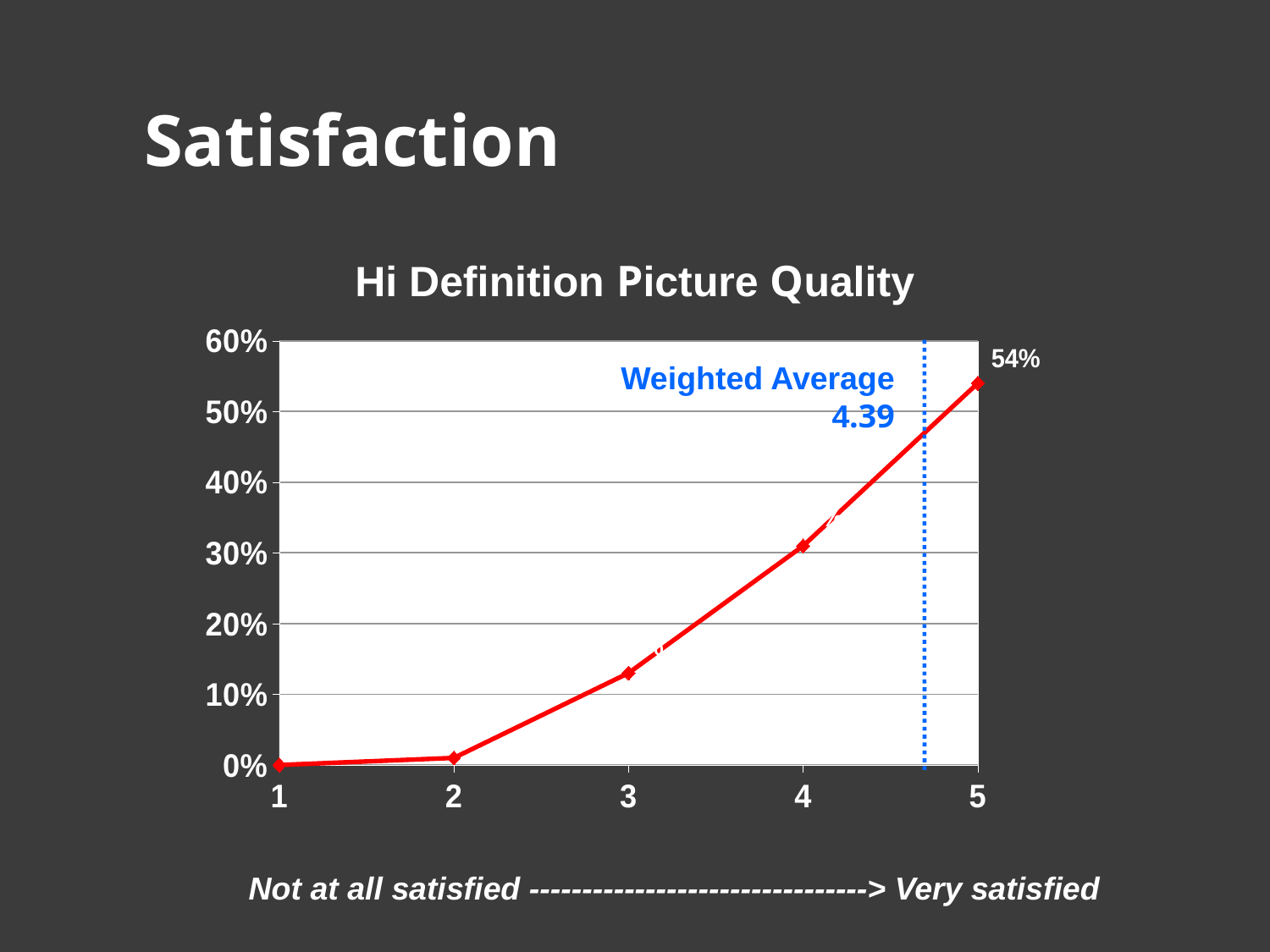
What weighted average is shown on the chart? 4.39 Which rating has the lowest value in the Hi Definition Picture Quality chart? 1 Which has a larger value, rating 3 or rating 4? 4 Is the value for rating 4 greater or less than 40%? less Do the values rise or fall as the rating increases from 1 to 5? rise Is the value for rating 2 greater or less than 10%? less What kind of chart is shown on the slide? line chart Which rating has the highest value in the Hi Definition Picture Quality chart? 5 Is the value for rating 3 greater or less than 20%? less How many rating points are plotted on the x axis? 5 What is the value at rating 5 in the Hi Definition Picture Quality chart? 54%